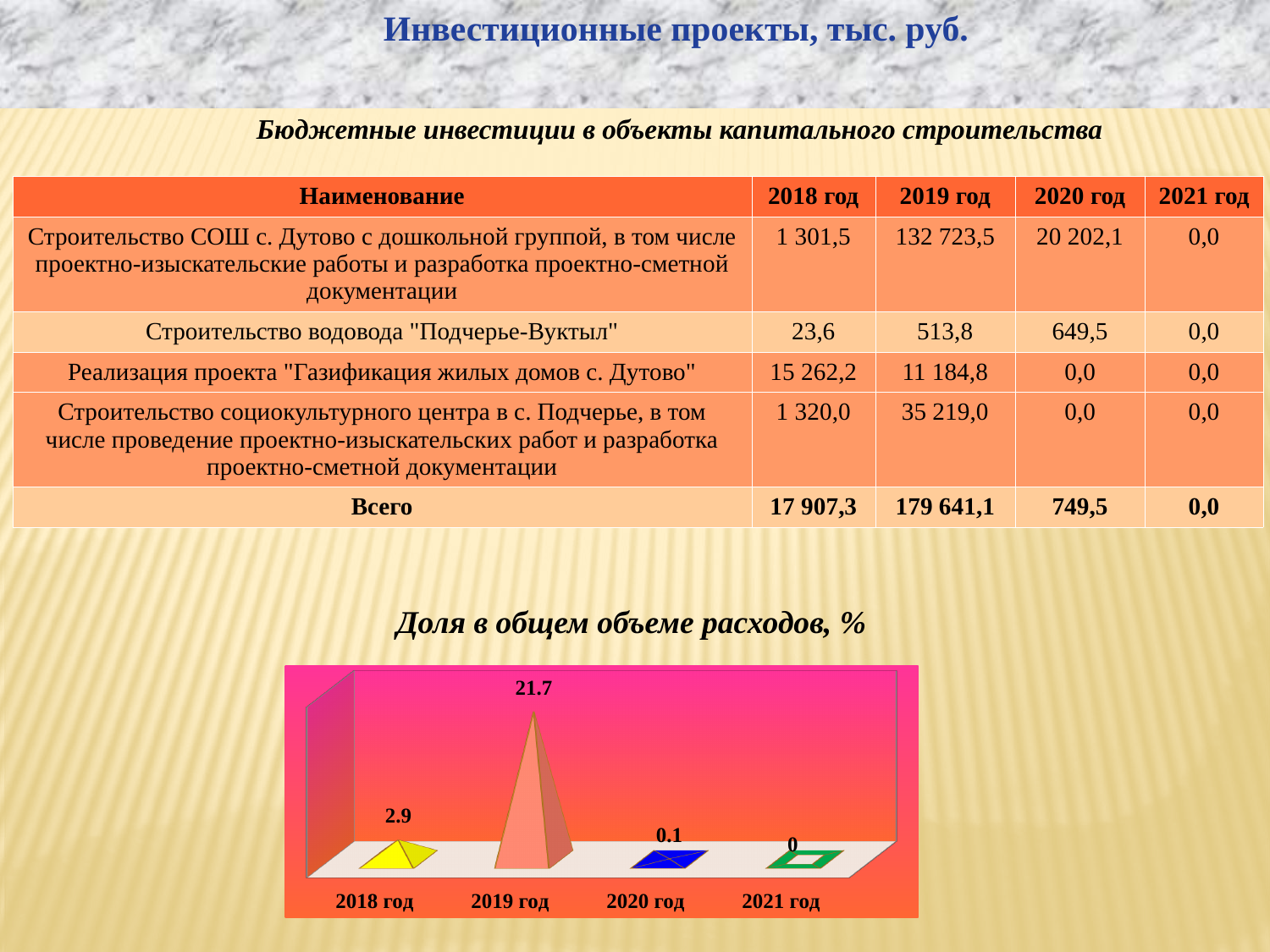
What is the title of the chart at the bottom of the slide? Доля в общем объеме расходов, % How many categories are shown in the chart 'Доля в общем объеме расходов, %'? 4 In the chart 'Доля в общем объеме расходов, %', do the values rise or fall from 2019 год to 2021 год? Fall In the chart 'Доля в общем объеме расходов, %', which year has the highest value? 2019 год What kind of chart is 'Доля в общем объеме расходов, %'? Bar chart In the chart 'Доля в общем объеме расходов, %', which year has the lowest value? 2021 год In the chart 'Доля в общем объеме расходов, %', what is the value for 2019 год? 21.7 In the chart 'Доля в общем объеме расходов, %', which is larger, the value for 2018 год or the value for 2020 год? 2018 год In the chart 'Доля в общем объеме расходов, %', what is the value for 2021 год? 0 In the chart 'Доля в общем объеме расходов, %', what is the value for 2020 год? 0.1 In the chart 'Доля в общем объеме расходов, %', what is the difference between the values for 2019 год and 2018 год? 18.8 In the chart 'Доля в общем объеме расходов, %', what is the value for 2018 год? 2.9